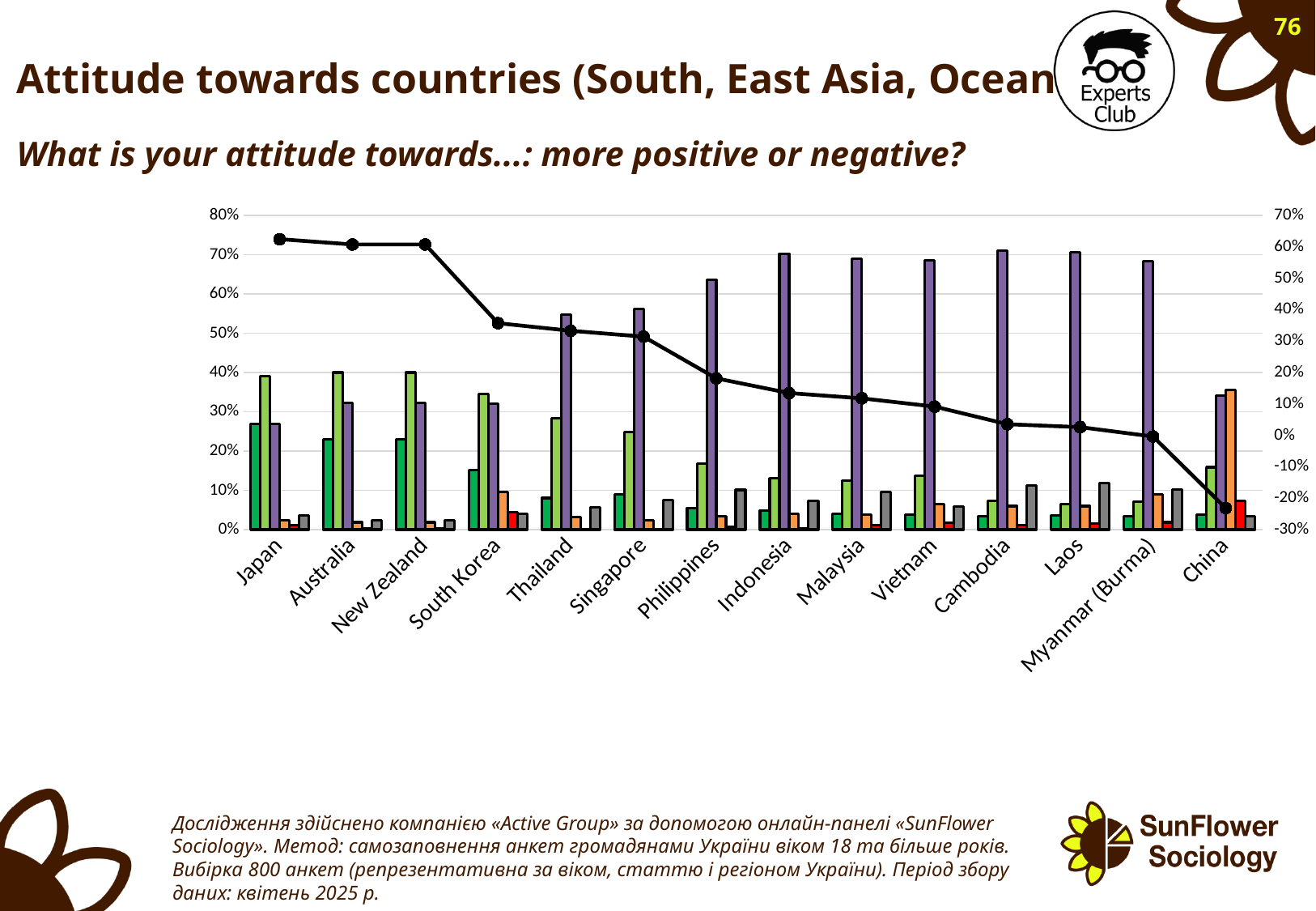
For which country does the black line reach its lowest point? China What is the highest value shown on the left-hand vertical axis? 80% On the right-hand axis, is the black line value for China greater or less than 0%? less On the right-hand axis, is the black line value for South Korea greater or less than 30%? greater On the right-hand axis, is the black line value for Japan greater or less than 50%? greater How many countries are listed along the x axis of the chart? 14 Is the black line value for Japan larger or smaller than the black line value for Thailand? Larger Which country is listed first (leftmost) on the x axis? Japan Which country is listed last (rightmost) on the x axis? China Does the black line generally rise or fall moving from Japan on the left to China on the right? Fall What kind of chart is shown on the slide? A bar chart combined with a line